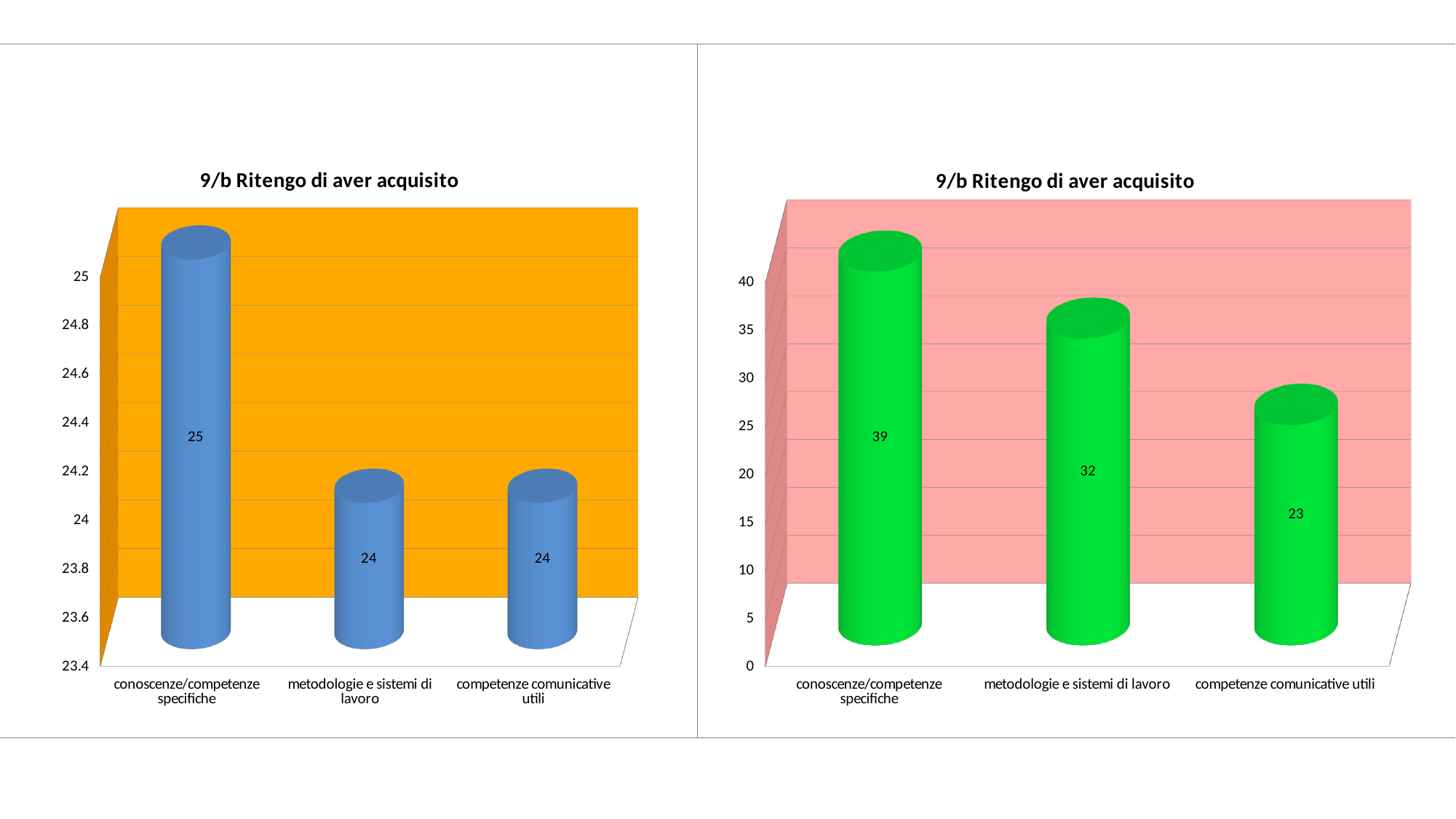
How many categories are shown in the right chart? 3 In the left chart, what is the value for conoscenze/competenze specifiche? 25 What kind of chart is the left chart? bar chart In the right chart, what is the value for competenze comunicative utili? 23 In the right chart, which is larger: the value for metodologie e sistemi di lavoro or the value for competenze comunicative utili? metodologie e sistemi di lavoro In the right chart, which category has the highest value? conoscenze/competenze specifiche Do the values in the right chart rise or fall from left to right along the x axis? fall In the left chart, what is the value for metodologie e sistemi di lavoro? 24 In the right chart, what is the difference between the values for conoscenze/competenze specifiche and metodologie e sistemi di lavoro? 7 In the left chart, which category has the highest value? conoscenze/competenze specifiche In the right chart, which category has the lowest value? competenze comunicative utili In the right chart, what is the value for conoscenze/competenze specifiche? 39